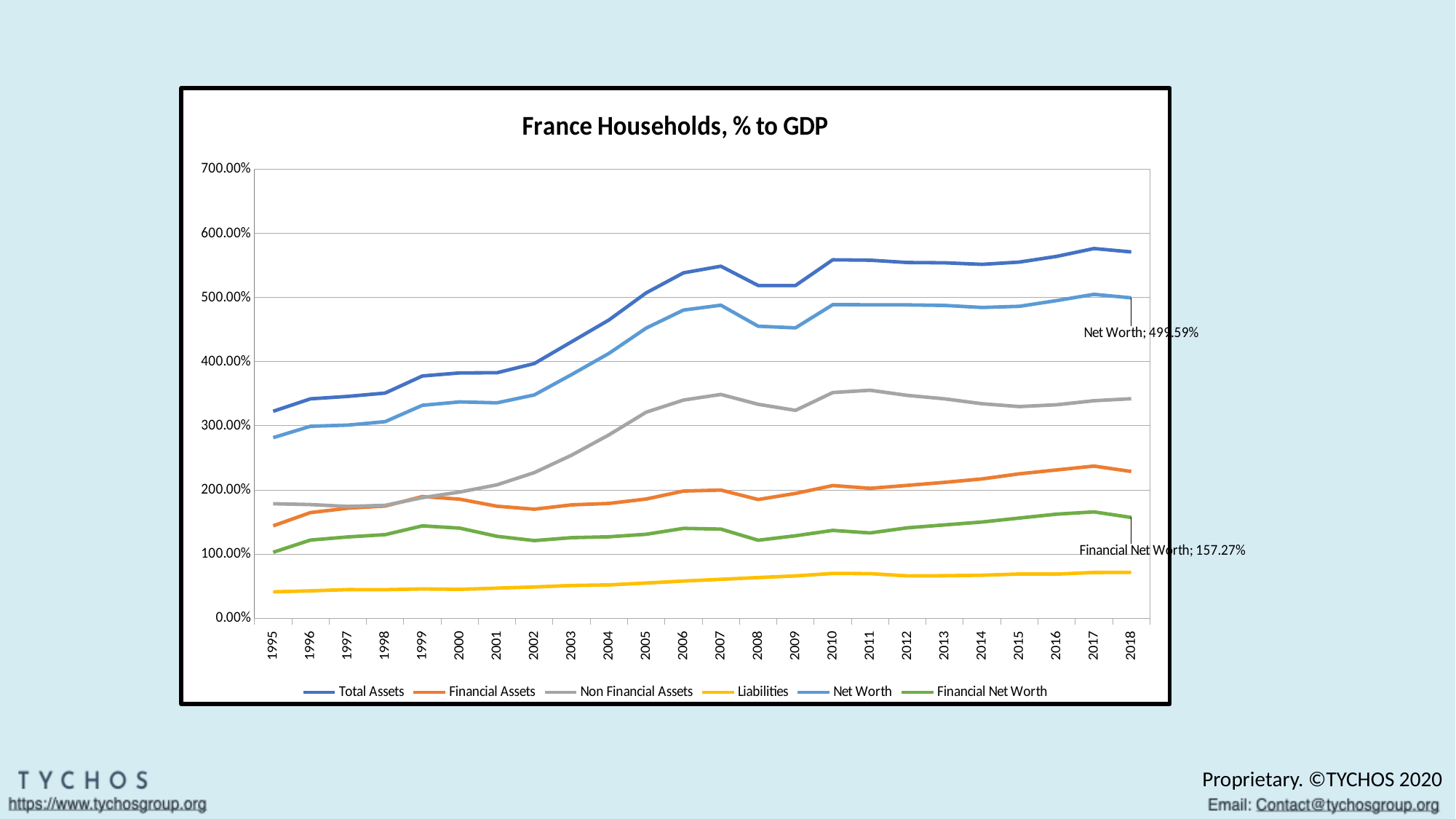
Which is larger in 2018, Non Financial Assets or Financial Assets? Non Financial Assets Which series has the highest value in 2018? Total Assets How many series does the legend list? 6 Which series has the lowest value across the chart? Liabilities How many years are shown on the x axis? 24 What kind of chart is shown on the slide? Line chart Is the value for Total Assets in 2018 greater or less than 500.00%? greater What is the difference between Net Worth and Financial Net Worth in 2018? 342.32% What is the value of Net Worth in 2018? 499.59% What is the title of the chart? France Households, % to GDP Is the value for Liabilities in 2018 greater or less than 100.00%? less What is the value of Financial Net Worth in 2018? 157.27%